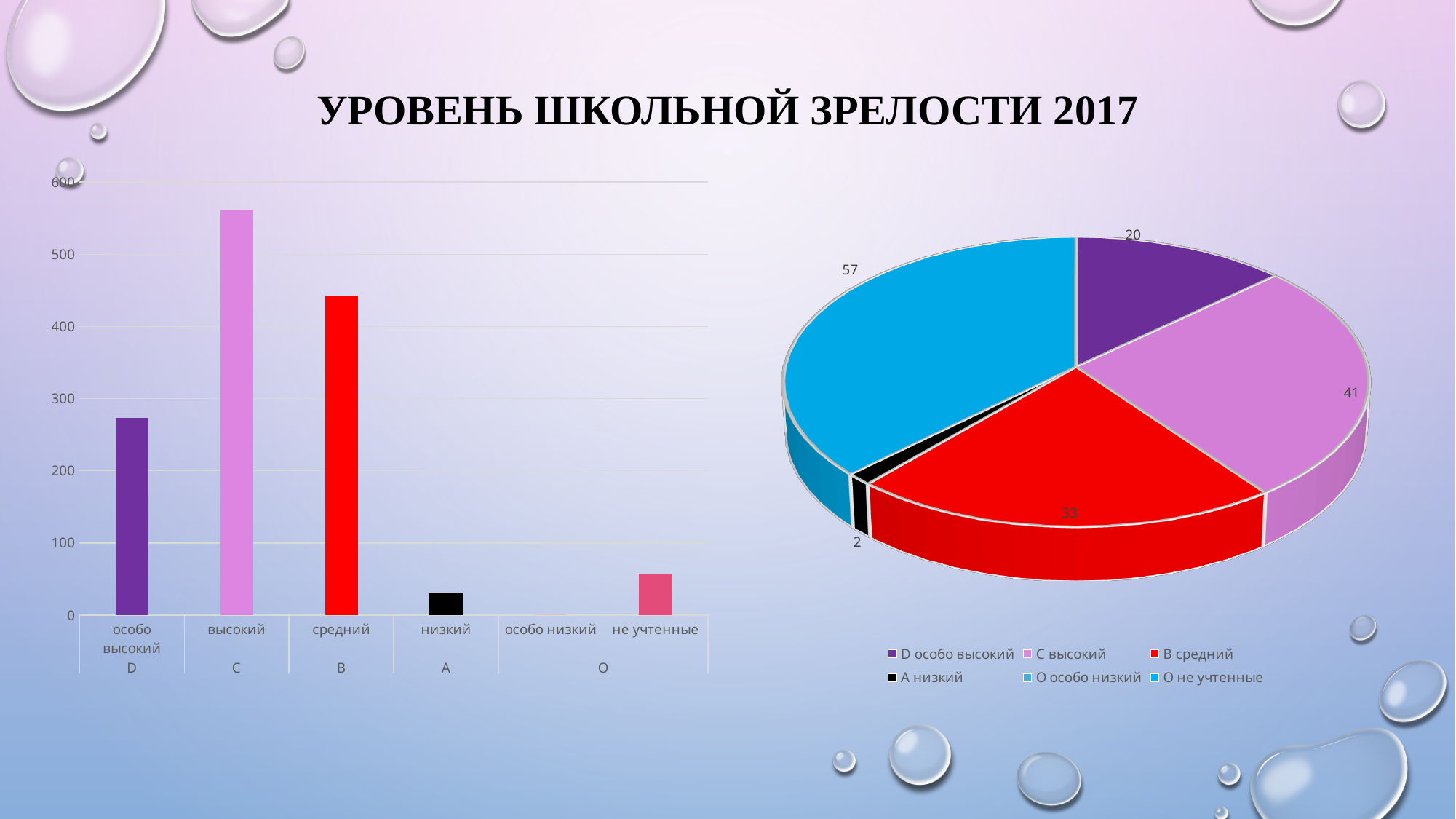
How many entries does the legend of the pie chart on the right list? 6 In the bar chart on the left, which is larger, the bar for средний B or the bar for особо высокий D? средний B In the pie chart on the right, what value is shown for the slice O не учтенные? 57 In the bar chart on the left, is the value for средний B greater or less than 400? greater In the pie chart on the right, what value is shown for the slice C высокий? 41 In the pie chart on the right, what is the difference between the values for B средний and D особо высокий? 13 In the bar chart on the left, is the value for высокий C greater or less than 500? greater In the bar chart on the left, which category has the highest bar? высокий C In the bar chart on the left, is the value for особо высокий D greater or less than 300? less What kind of chart is on the right side of the slide? pie chart What kind of chart is on the left side of the slide? bar chart